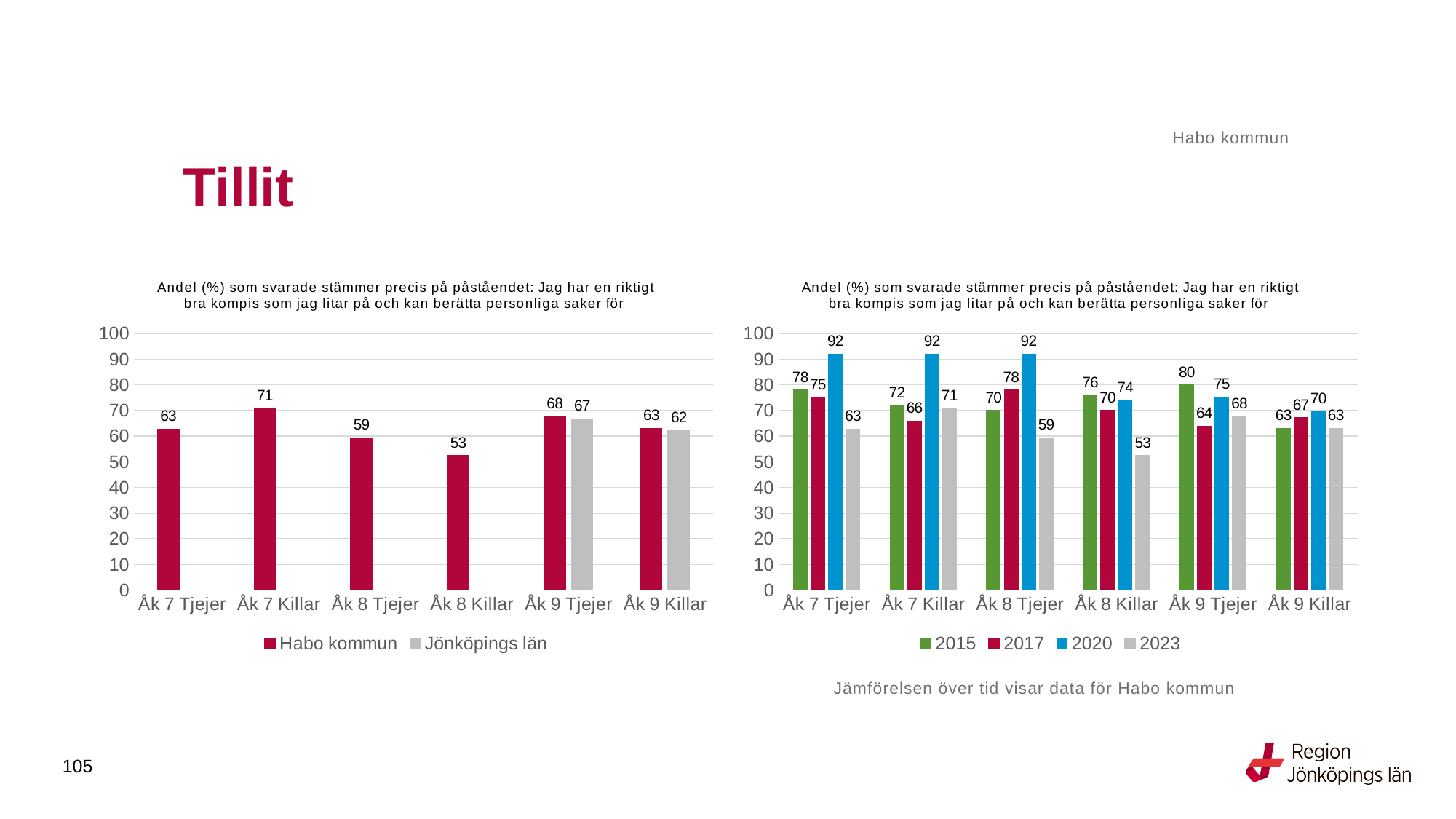
In the right chart, what is the value for 2020 for Åk 8 Killar? 74 In the right chart, what is the difference between the 2020 and 2023 values for Åk 8 Tjejer? 33 What kind of chart is the left chart? Bar chart In the left chart, which category has the lowest value for Habo kommun? Åk 8 Killar In the right chart, which category has the highest value for 2015? Åk 9 Tjejer In the left chart, what is the difference between Habo kommun and Jönköpings län for Åk 9 Tjejer? 1 In the left chart, what is the value for Habo kommun for Åk 7 Killar? 71 How many categories are shown on the x axis of the right chart? 6 In the right chart, which year is shown in blue in the legend? 2020 In the right chart, which is larger for Åk 8 Tjejer: the 2015 value or the 2017 value? 2017 In the left chart, how many series does the legend list? 2 In the right chart, how many series does the legend list? 4